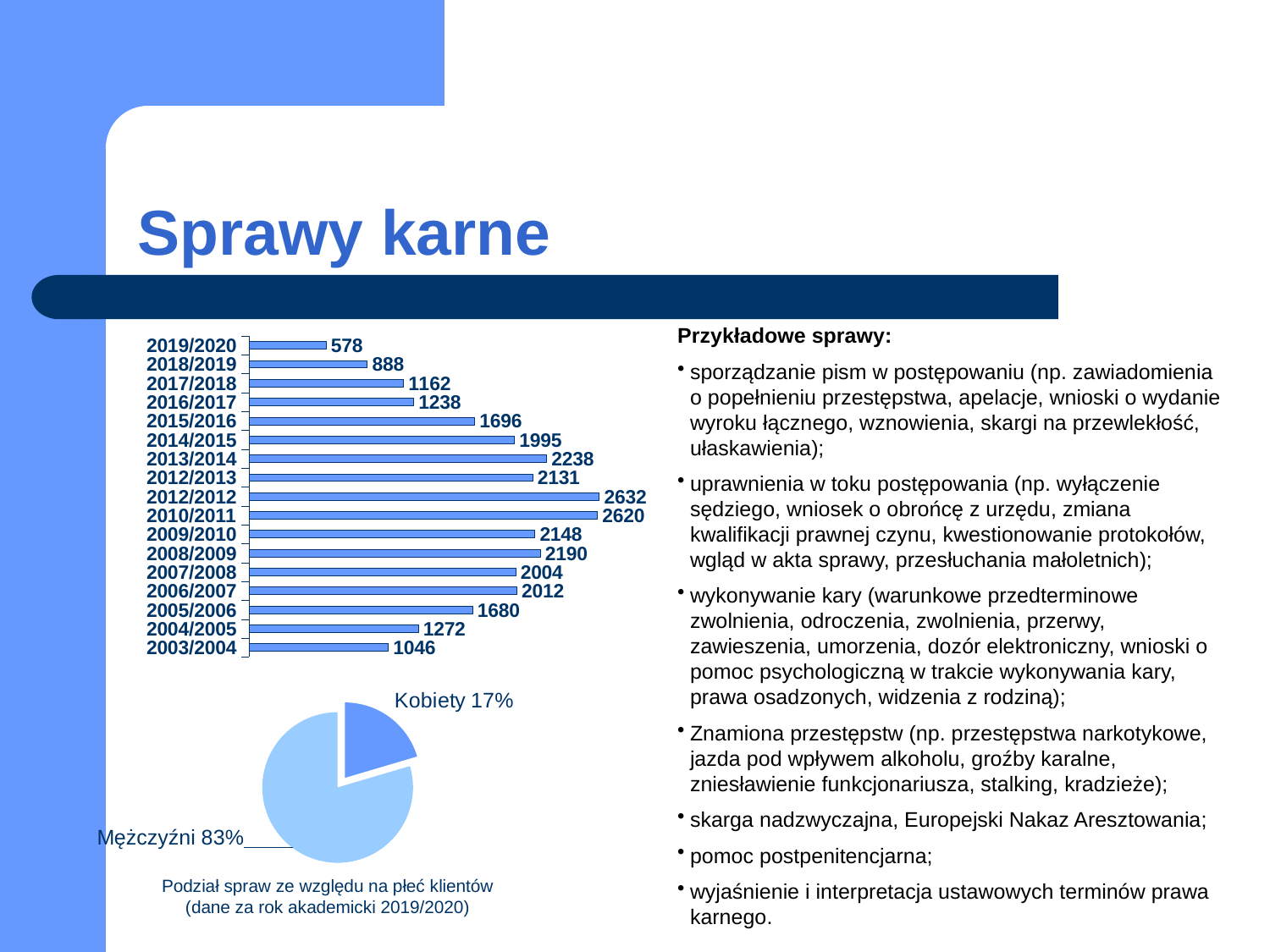
In the bar chart on the left, what is the value for 2003/2004? 1046 In the bar chart on the left, what is the value for 2013/2014? 2238 In the bar chart on the left, what is the highest value shown? 2632 In the bar chart on the left, which is larger, the value for 2008/2009 or the value for 2009/2010? 2008/2009 In the bar chart on the left, which academic year has the lowest value? 2019/2020 What kind of chart is the upper chart on the left? bar chart In the bar chart on the left, what is the difference between the values for 2014/2015 and 2015/2016? 299 In the pie chart on the left, what share of cases is for Mężczyźni? 83% In the bar chart on the left, do the values rise or fall from 2015/2016 to 2019/2020? fall In the pie chart on the left, what share of cases is for Kobiety? 17% How many academic years are shown in the bar chart on the left? 17 In the bar chart on the left, what is the value for 2019/2020? 578